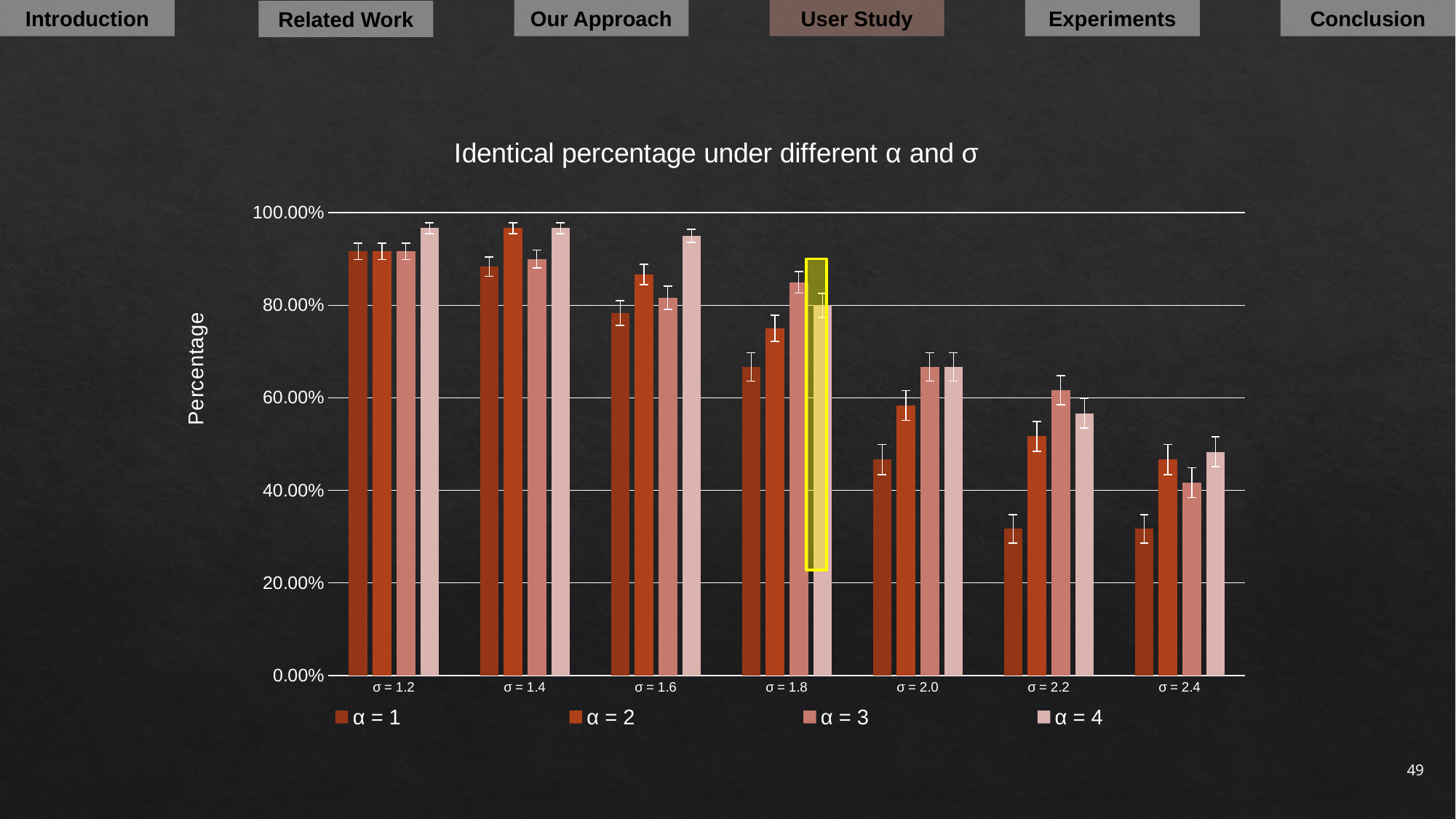
What kind of chart is shown on the slide? bar chart At σ = 1.2, which is larger: the value for α = 1 or for α = 4? α = 4 Is the value for α = 2 at σ = 2.2 greater or less than 60.00%? less Is the value for α = 4 at σ = 1.2 greater or less than 80.00%? greater Is the value for α = 1 at σ = 2.4 greater or less than 40.00%? less At σ = 2.0, which series has the lowest value? α = 1 How many series does the legend list? 4 What is the title of the chart? Identical percentage under different α and σ How many σ categories are shown on the x axis? 7 What is the label of the y axis? Percentage Do the values for α = 4 rise or fall as σ increases from 1.2 to 2.4? fall